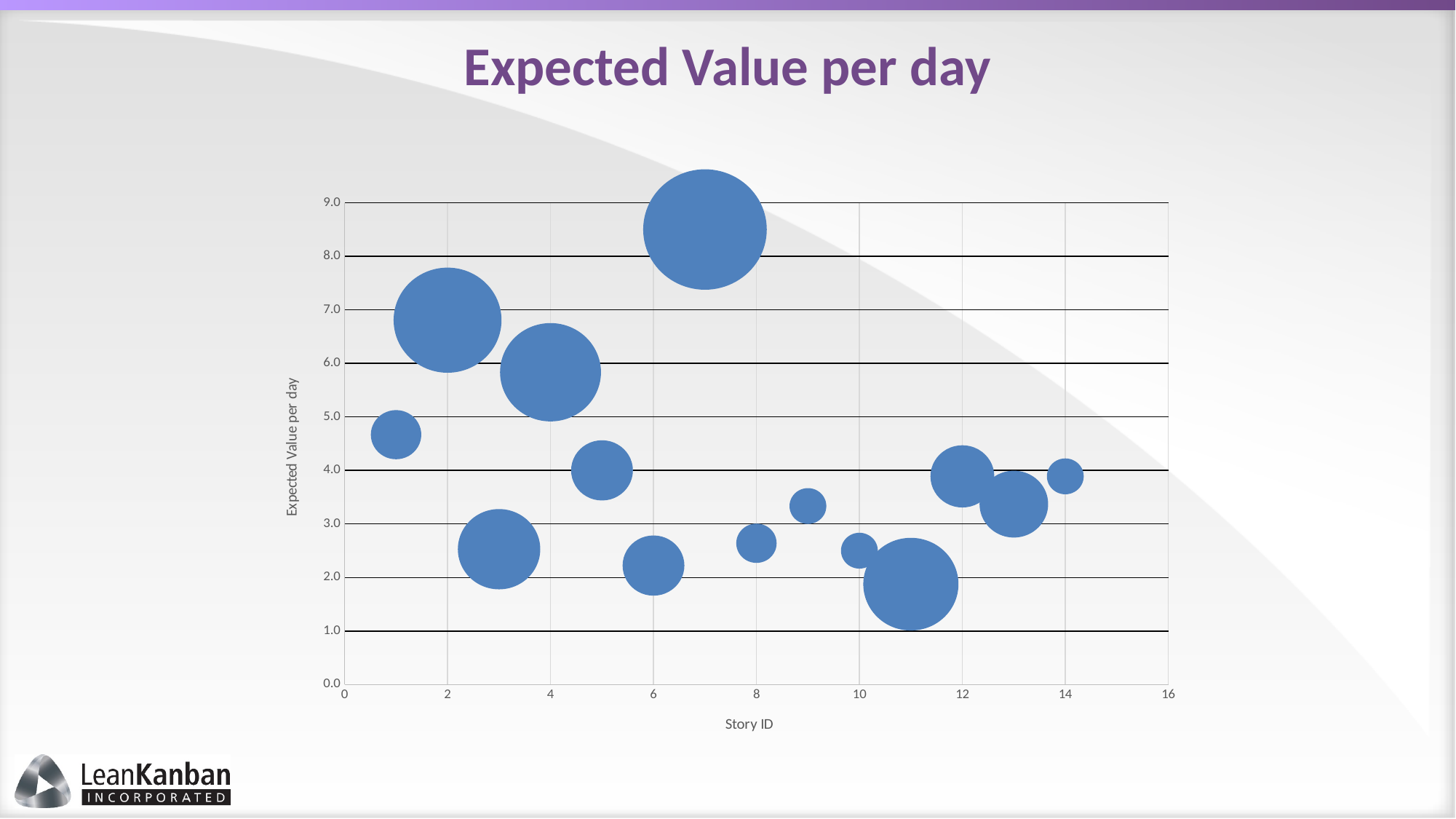
Is the expected value per day for Story ID 2 greater or less than 6.0? greater Which has a higher expected value per day, Story ID 2 or Story ID 4? Story ID 2 Is the expected value per day for Story ID 7 greater or less than 8.0? greater What kind of chart is shown on the slide? Bubble chart What is the label of the x axis? Story ID Is the expected value per day for Story ID 3 greater or less than 3.0? less What is the title of the chart? Expected Value per day How many bubbles (stories) are plotted on the chart? 14 Which Story ID has the highest expected value per day? 7 Which Story ID has the lowest expected value per day? 11 Which has a higher expected value per day, Story ID 1 or Story ID 6? Story ID 1